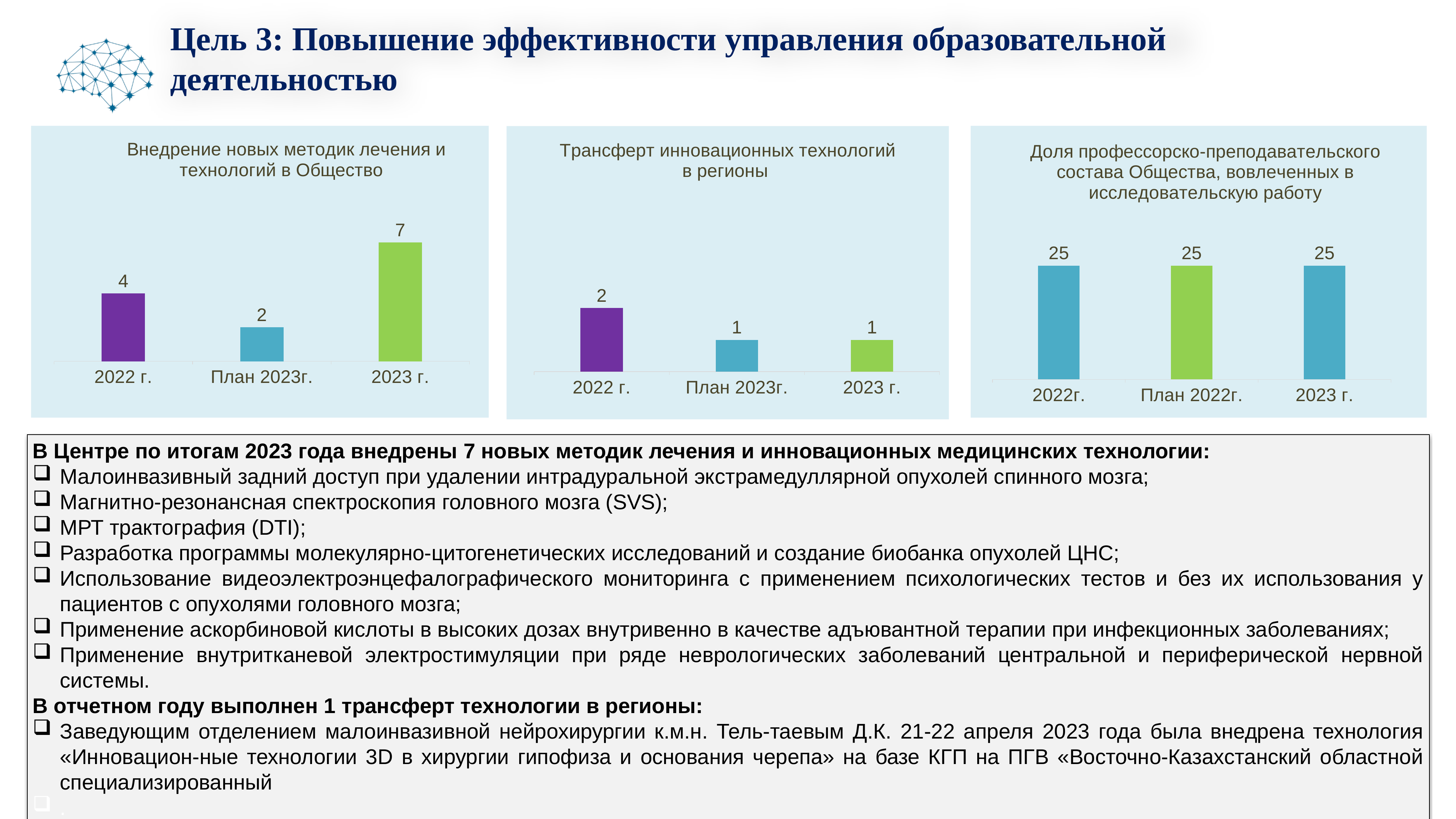
In the chart 'Доля профессорско-преподавательского состава Общества, вовлеченных в исследовательскую работу', what is the value for 2023 г.? 25 In the chart 'Внедрение новых методик лечения и технологий в Общество', what is the difference between the values for 2023 г. and План 2023г.? 5 In the chart 'Внедрение новых методик лечения и технологий в Общество', what colour is the bar for 2023 г.? Green What kind of chart is the chart 'Внедрение новых методик лечения и технологий в Общество'? Bar chart In the chart 'Доля профессорско-преподавательского состава Общества, вовлеченных в исследовательскую работу', do the values change across the categories? No, all are 25 How many charts are shown on the slide? 3 In the chart 'Внедрение новых методик лечения и технологий в Общество', what is the value for 2023 г.? 7 In the chart 'Трансферт инновационных технологий в регионы', what is the value for 2022 г.? 2 In the chart 'Трансферт инновационных технологий в регионы', which is larger: the value for 2022 г. or the value for 2023 г.? 2022 г. In the chart 'Трансферт инновационных технологий в регионы', how many categories are shown? 3 In the chart 'Внедрение новых методик лечения и технологий в Общество', which category has the highest value? 2023 г. In the chart 'Внедрение новых методик лечения и технологий в Общество', which category has the lowest value? План 2023г.